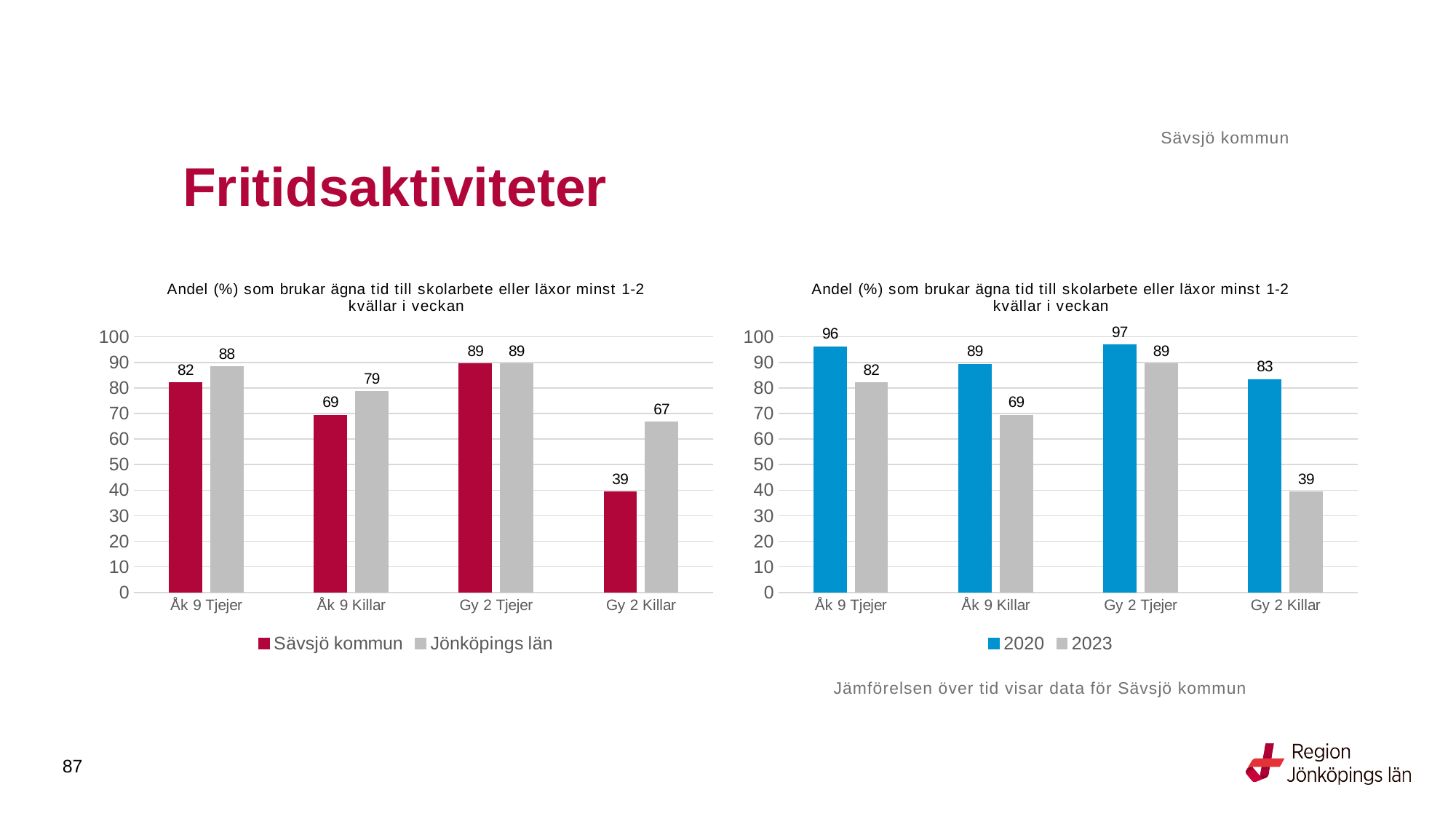
In the left chart, which category has the lowest value for Sävsjö kommun? Gy 2 Killar In the right chart, what is the difference between the 2020 and 2023 values for Gy 2 Killar? 44 How many categories are shown on the x axis of the right chart? 4 In the right chart, what is the 2020 value for Gy 2 Tjejer? 97 In the left chart, what is the value for Sävsjö kommun for Åk 9 Killar? 69 In the left chart, which is larger for Åk 9 Tjejer: Sävsjö kommun or Jönköpings län? Jönköpings län In the left chart, what is the difference between Jönköpings län and Sävsjö kommun for Gy 2 Killar? 28 What type of chart is the right chart? Bar chart In the right chart, which category has the highest 2020 value? Gy 2 Tjejer In the right chart, what is the 2023 value for Åk 9 Tjejer? 82 How many series does the legend of the left chart list? 2 In the left chart, what is the value for Jönköpings län for Gy 2 Killar? 67